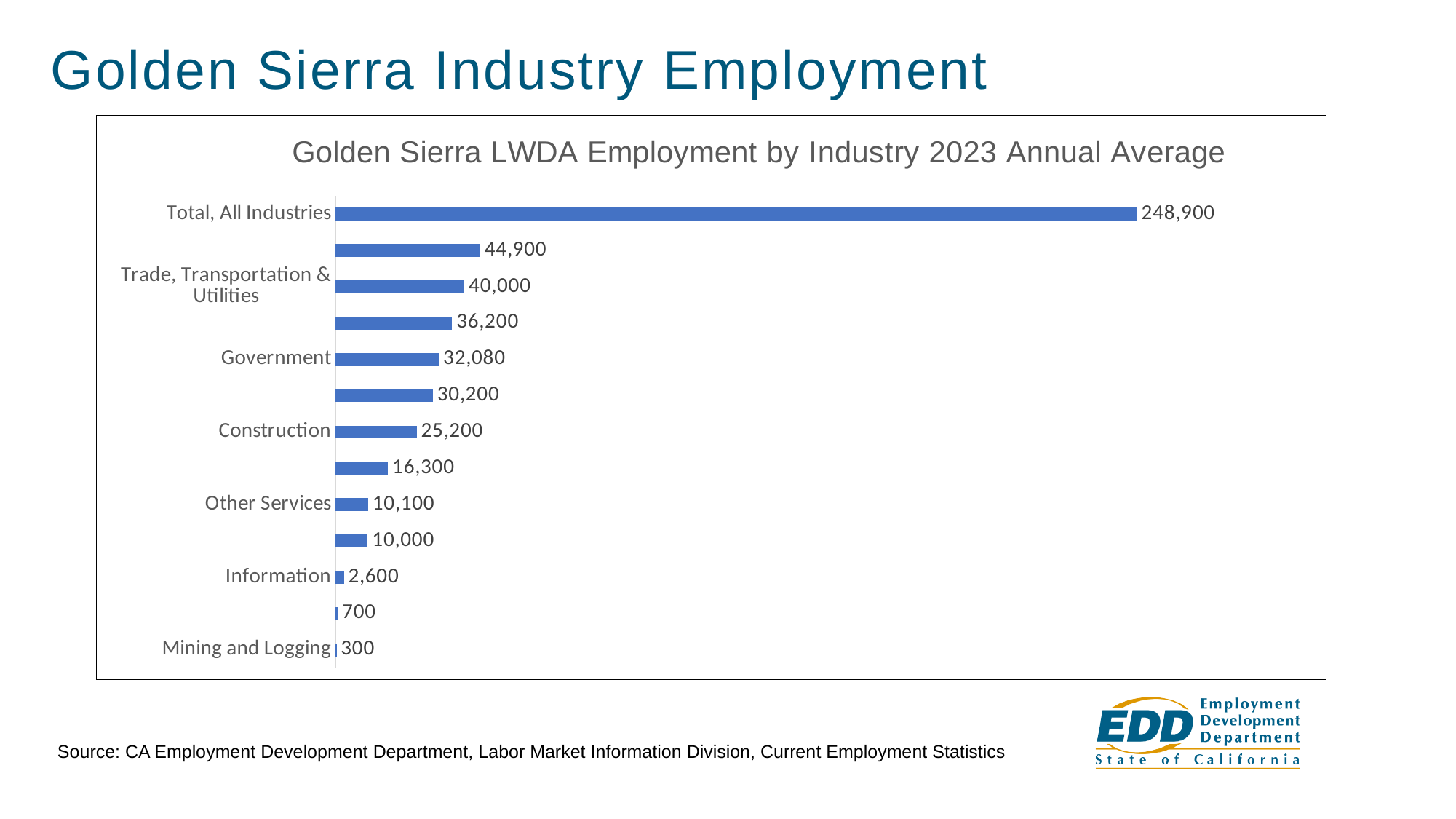
What is the chart's title? Golden Sierra LWDA Employment by Industry 2023 Annual Average What kind of chart is shown on the slide? bar chart What is the value for Other Services? 10,100 What is the value for Information? 2,600 What is the value for Government? 32,080 Which is larger, the value for Other Services or the value for Information? Other Services What is the value for Construction? 25,200 What is the value for Total, All Industries? 248,900 What is the value for Trade, Transportation & Utilities? 40,000 What is the difference between the values for Government and Construction? 6,880 Which category has the lowest value? Mining and Logging What is the value for Mining and Logging? 300